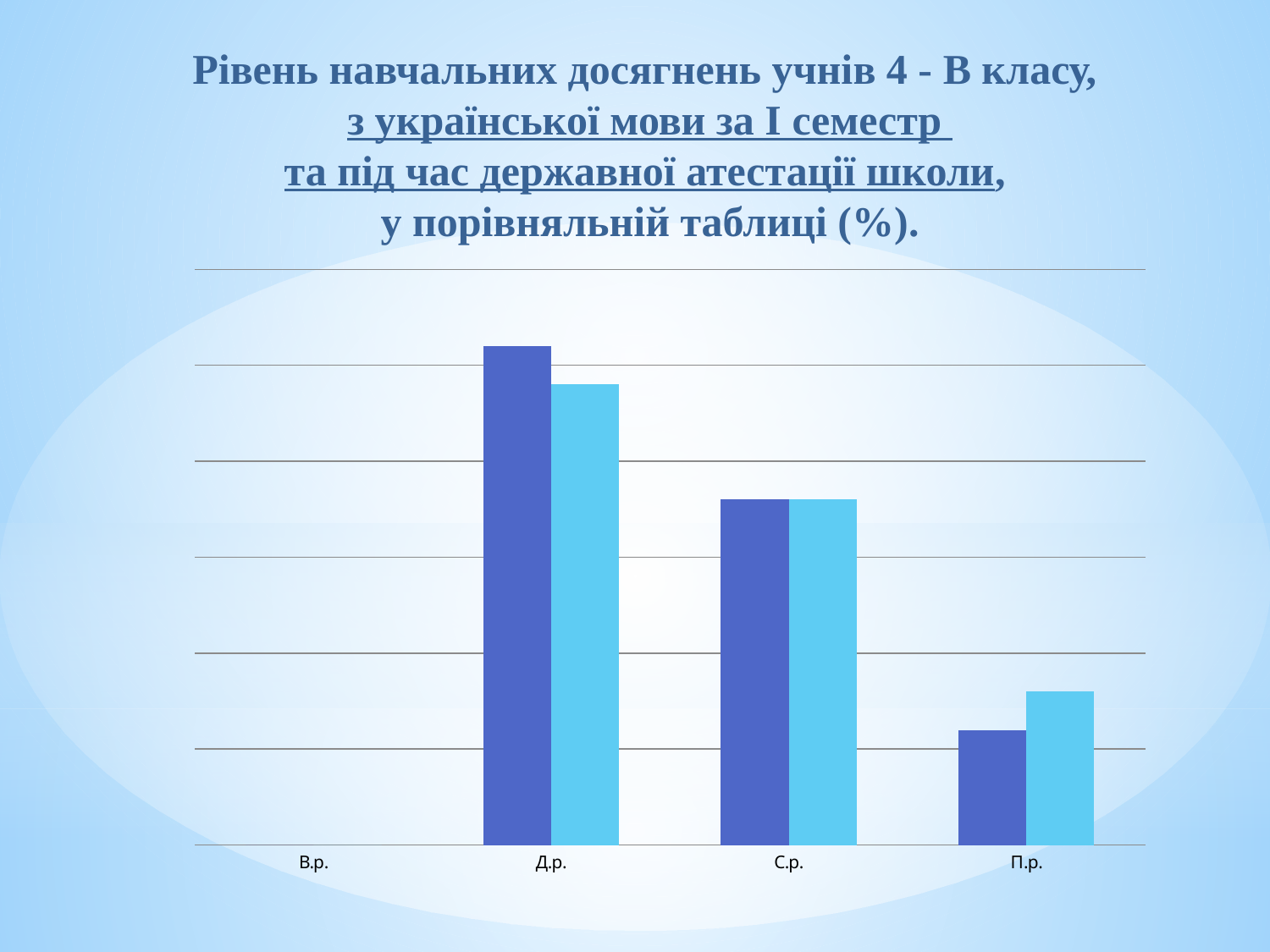
How many bar colours (series) are plotted for each category? 2 How many categories are shown on the x axis? 4 Among the categories with visible bars, which has the shortest light blue bar? П.р. What kind of chart is shown on the slide? bar chart Which category has the tallest dark blue bar? Д.р. Which category on the x axis has no visible bars? В.р. For П.р., which bar is taller: the dark blue or the light blue? light blue For Д.р., which bar is taller: the dark blue or the light blue? dark blue Do the dark blue bars rise or fall from Д.р. to П.р.? fall Which category has the tallest light blue bar? Д.р. Which category is higher for the dark blue series: Д.р. or С.р.? Д.р. Among the categories with visible bars, which has the shortest dark blue bar? П.р.